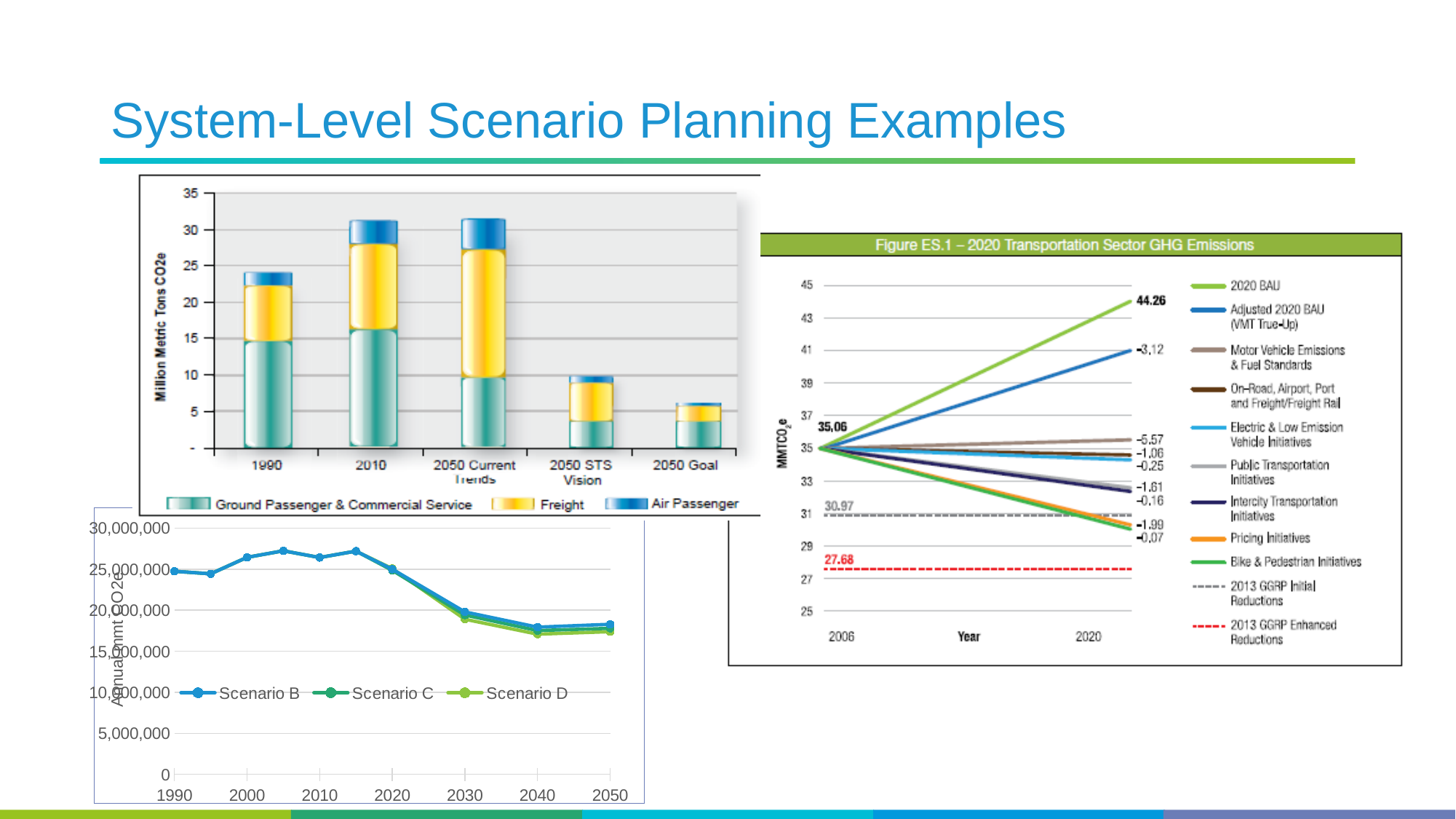
In the bottom-left line chart, is the value for Scenario B in 2050 greater or less than 15,000,000? greater In the bottom-left line chart, how many series does the legend list? 3 In the Figure ES.1 chart on the right, what is the value of the 2013 GGRP Enhanced Reductions line? 27.68 In the Figure ES.1 chart on the right, what is the difference between the 2020 BAU value (44.26) and the 2006 starting value (35.06)? 9.20 In the top-left chart, is the total for 1990 greater or less than 25? less In the top-left stacked bar chart, how many series does the legend list? 3 In the top-left stacked bar chart, how many categories are shown on the x axis? 5 In the top-left chart, is the total for 2050 Goal greater or less than 5? greater What kind of chart is the bottom-left chart with Scenario B, C and D? line chart In the bottom-left line chart, do the values rise or fall between 2020 and 2050? fall In the Figure ES.1 chart on the right, what is the 2020 BAU value? 44.26 In the top-left stacked bar chart, which category has the lowest total? 2050 Goal